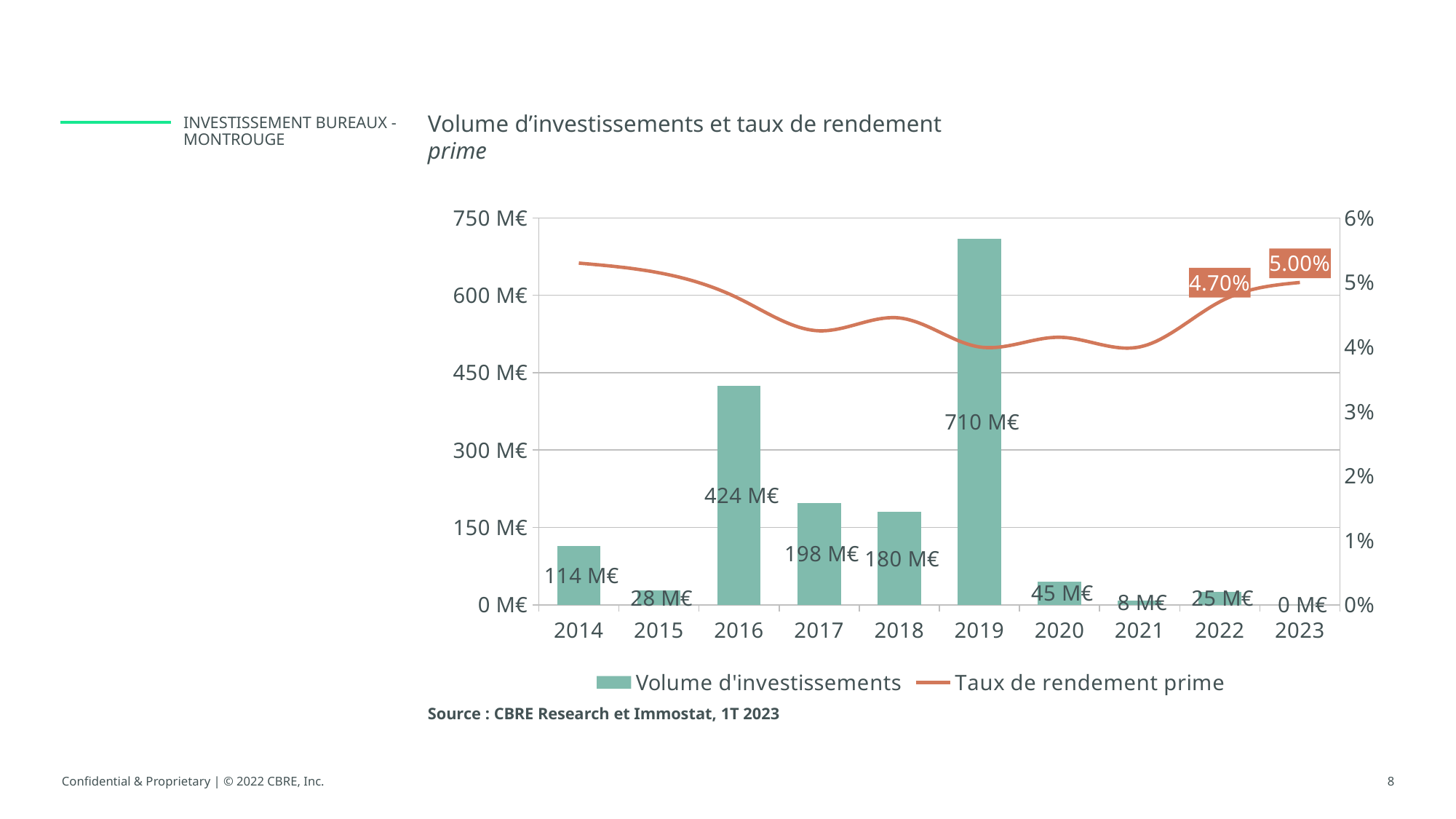
Which year has the lowest Volume d'investissements? 2023 What is the Volume d'investissements for 2021? 8 M€ Is the Taux de rendement prime for 2014 greater or less than 5%? greater What is the Taux de rendement prime for 2022? 4.70% Which year has a larger Volume d'investissements, 2017 or 2018? 2017 What kind of chart is this? Combined bar and line chart How many years are shown on the x axis? 10 What is the difference between the Volume d'investissements in 2019 and in 2016? 286 M€ How many series does the legend list? 2 What is the Volume d'investissements for 2016? 424 M€ Which year has the highest Volume d'investissements? 2019 What is the Taux de rendement prime for 2023? 5.00%